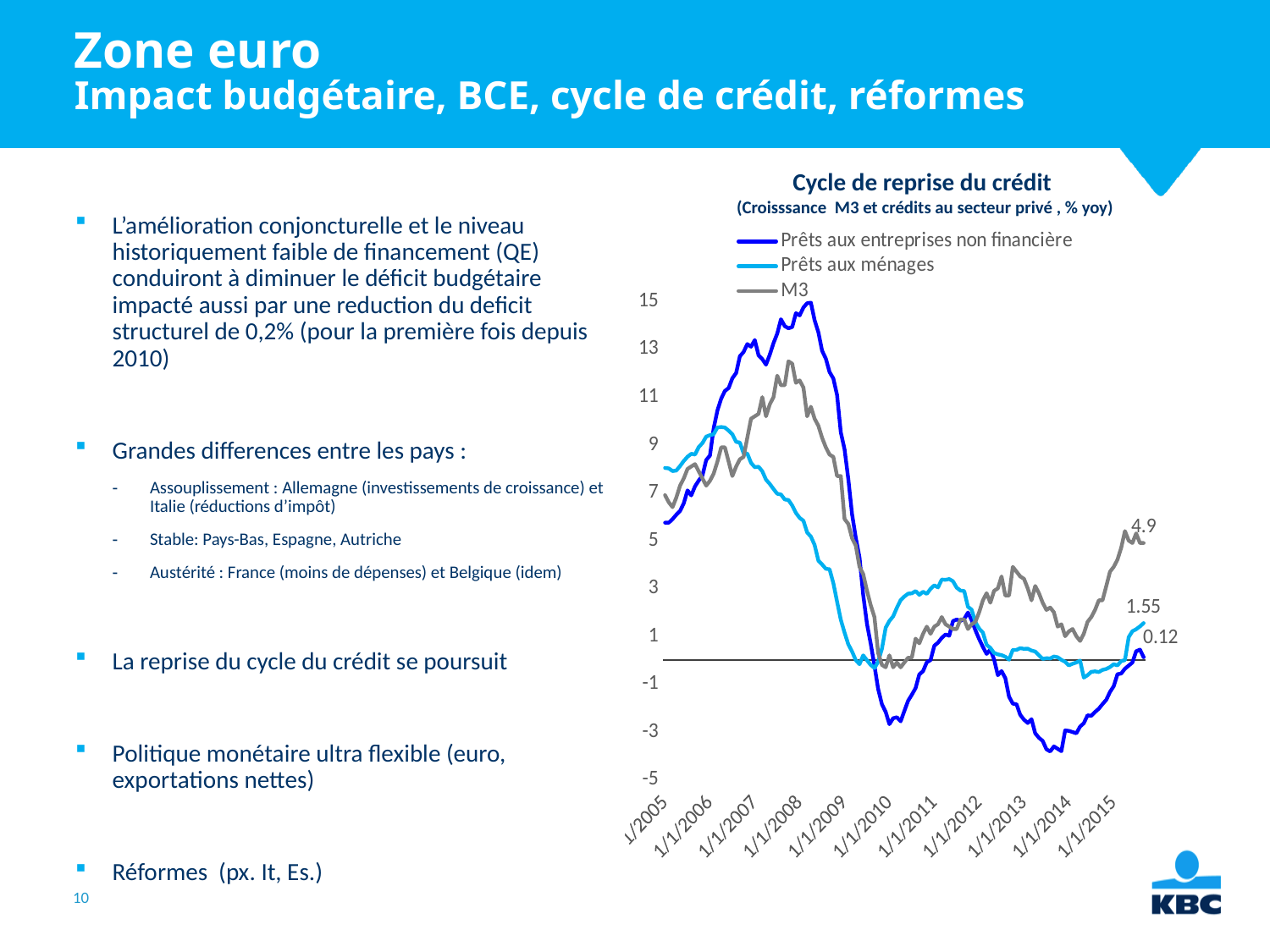
How many series does the legend of the chart list? 3 What is the title of the chart? Cycle de reprise du crédit What is the last labelled value of the Prêts aux entreprises non financière series? 0.12 Which series has the lowest final labelled value? Prêts aux entreprises non financière Which series has the highest final labelled value? M3 What is the difference between the final labelled values of M3 and Prêts aux ménages? 3.35 Does the Prêts aux entreprises non financière series rise or fall between 1/1/2005 and 1/1/2008? rise Is the peak value of the Prêts aux entreprises non financière series around 2008 greater or less than 13? greater What is the last labelled value of the Prêts aux ménages series? 1.55 What kind of chart is shown on the slide? line chart What is the difference between the final labelled values of Prêts aux ménages and Prêts aux entreprises non financière? 1.43 What is the last labelled value of the M3 series? 4.9